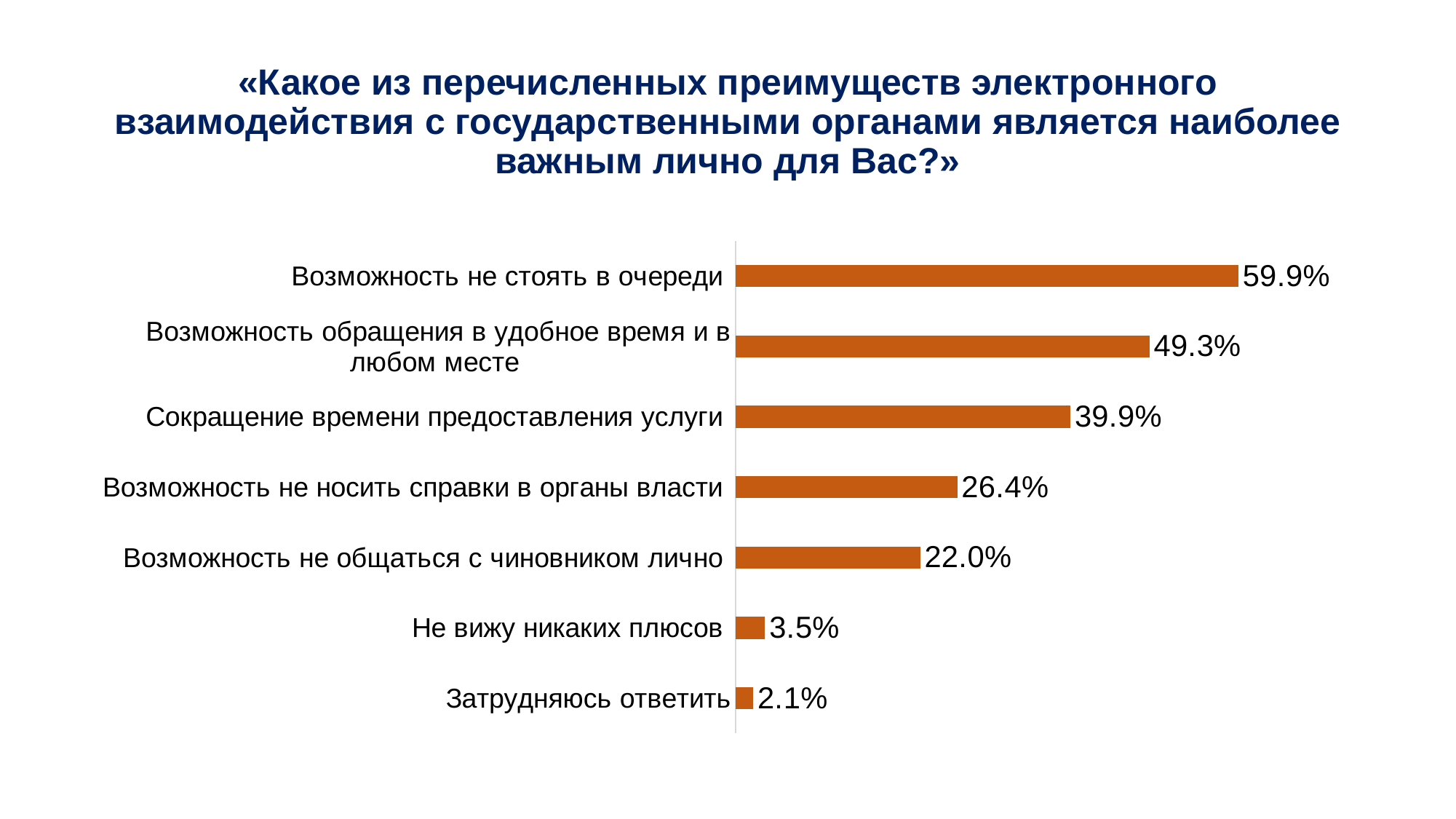
Which category has the highest value? Возможность не стоять в очереди Which category has the lowest value? Затрудняюсь ответить What kind of chart is shown on the slide? Bar chart What value is shown for "Не вижу никаких плюсов"? 3.5% What colour are the bars in the chart? Orange What value is shown for "Возможность не стоять в очереди"? 59.9% What is the difference between "Возможность не стоять в очереди" and "Возможность обращения в удобное время и в любом месте"? 10.6% What value is shown for "Сокращение времени предоставления услуги"? 39.9% Which is larger: "Сокращение времени предоставления услуги" or "Возможность не носить справки в органы власти"? Сокращение времени предоставления услуги How many categories are shown in the chart? 7 What value is shown for "Возможность не общаться с чиновником лично"? 22.0% What is the difference between "Возможность не носить справки в органы власти" and "Возможность не общаться с чиновником лично"? 4.4%